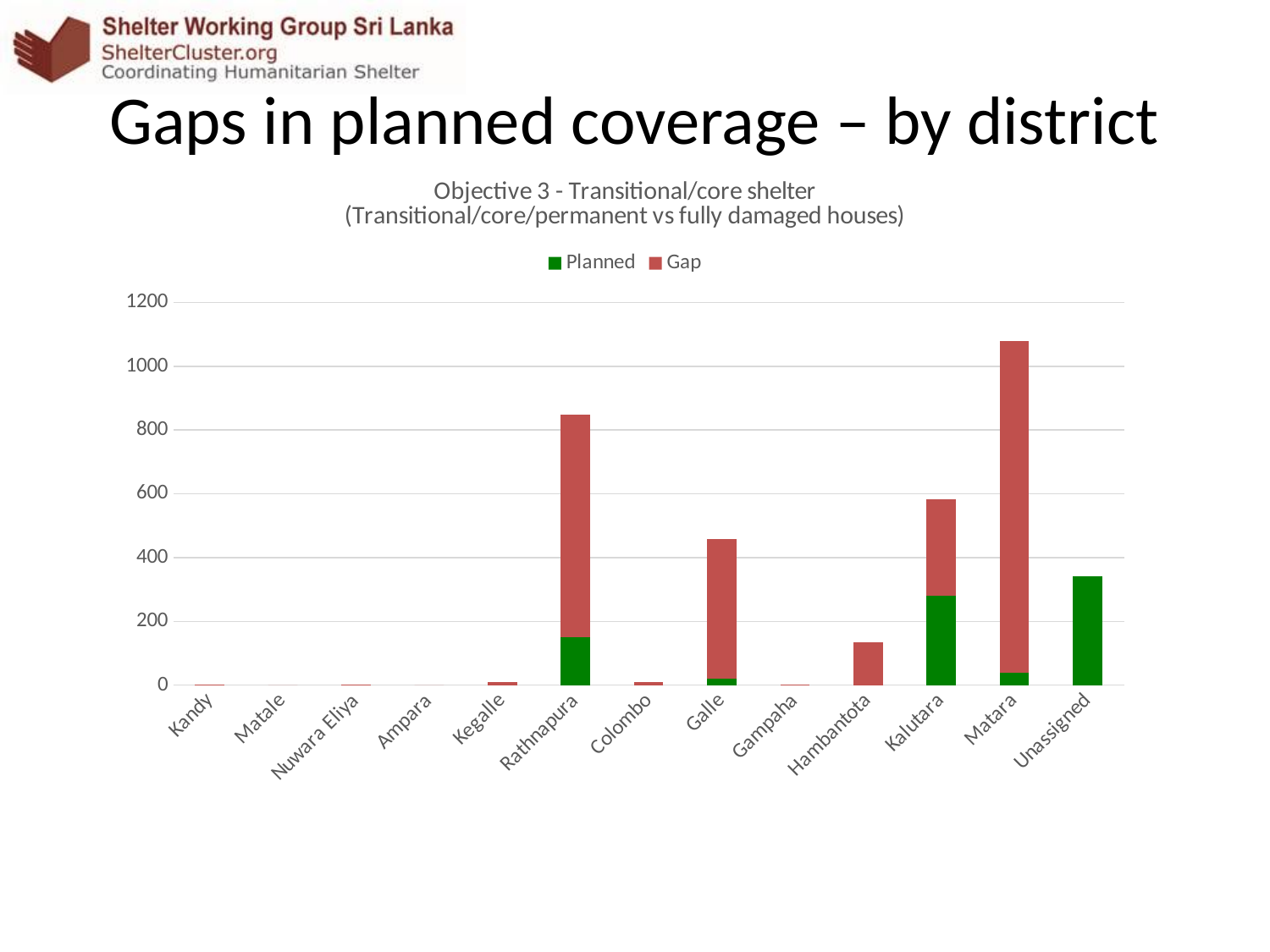
How many series does the legend list? 2 What kind of chart is shown on the slide? Stacked bar chart What is the title of the chart? Objective 3 - Transitional/core shelter (Transitional/core/permanent vs fully damaged houses) Is the total bar for Rathnapura greater or less than 800? greater Is the total bar for Matara greater or less than 1000? greater Which colour represents the Gap series in the legend? Red Is the total bar for Hambantota greater or less than 200? less How many categories are shown on the x axis? 13 Which has the larger Planned segment, Unassigned or Kalutara? Unassigned Which has the taller total bar, Rathnapura or Galle? Rathnapura Which district has the tallest bar overall? Matara